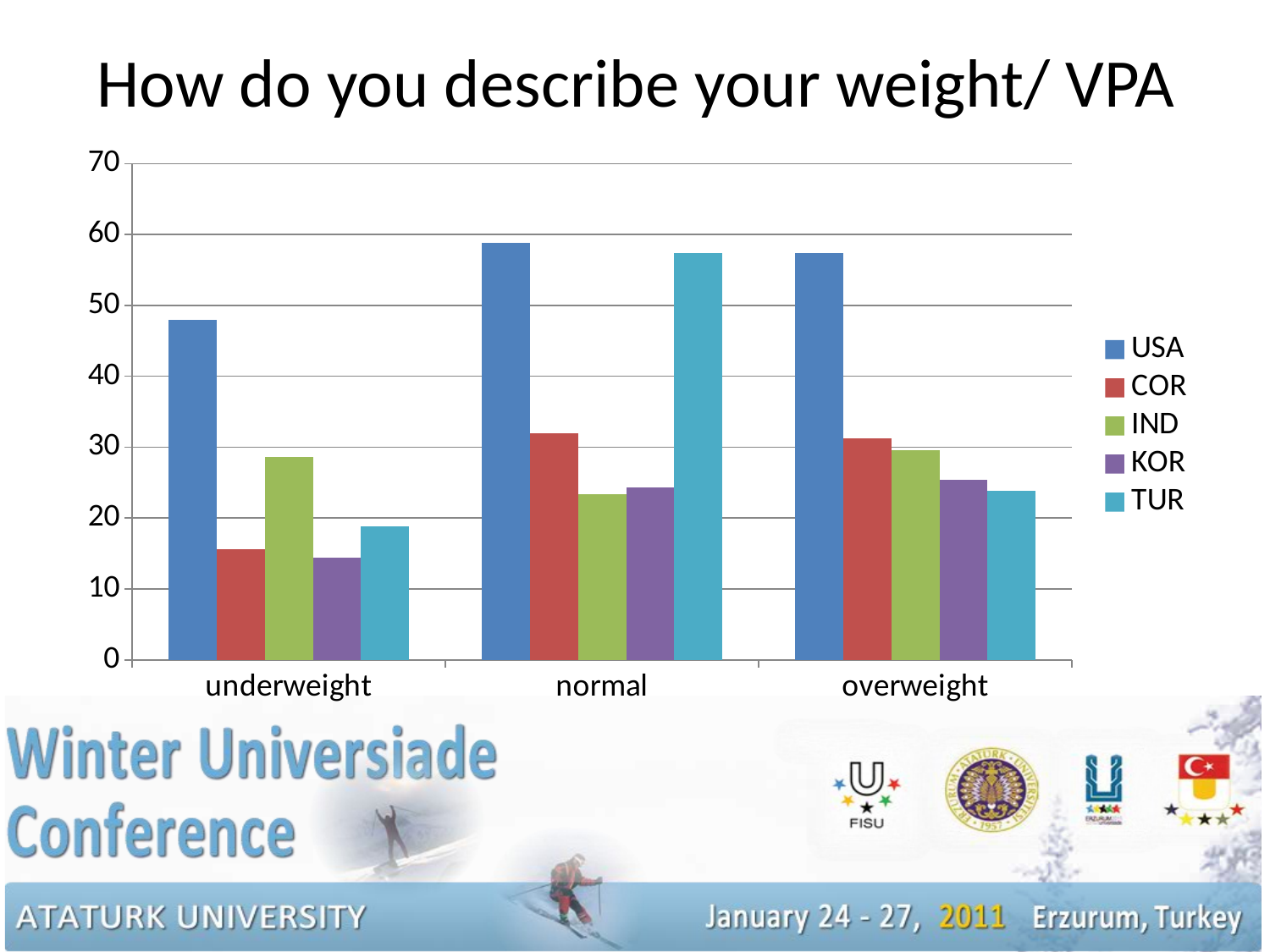
What kind of chart is shown on the slide? bar chart Which series has the highest value in the overweight category? USA What is the title of the chart? How do you describe your weight/ VPA Is the value for KOR in the overweight category greater or less than 30? less Which series has the highest value in the underweight category? USA Is the value for USA in the underweight category greater or less than 40? greater How many weight categories are shown on the x axis? 3 In the normal category, which is larger, the value for COR or the value for IND? COR How many series does the legend list? 5 Is the value for COR in the underweight category greater or less than 20? less In the underweight category, which is larger, the value for IND or the value for TUR? IND